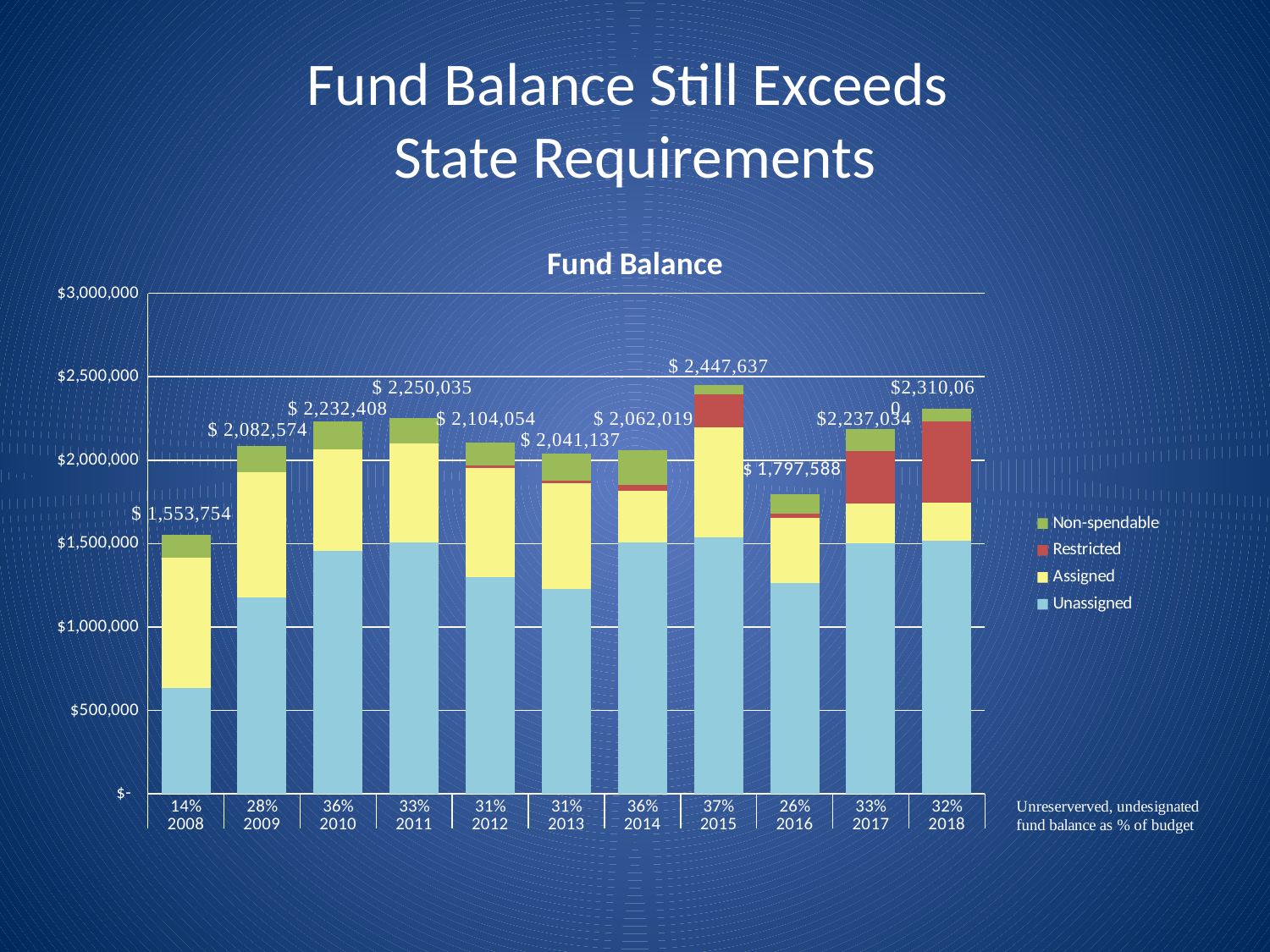
Which year has the lowest total fund balance? 2008 How many series does the legend list? 4 What is the difference between the total fund balance in 2015 and in 2008? $893,883 What is the difference between the total fund balance in 2018 and in 2017? $73,026 What is the total fund balance shown for 2015? $ 2,447,637 How many years are shown on the x axis of the chart? 11 What is the total fund balance shown for 2008? $ 1,553,754 Which year has a larger total fund balance, 2016 or 2013? 2013 Which year has the highest total fund balance? 2015 What kind of chart is used to show the fund balance? Stacked bar chart What is the total fund balance shown for 2018? $2,310,060 Is the Unassigned value for 2008 greater or less than $1,000,000? less